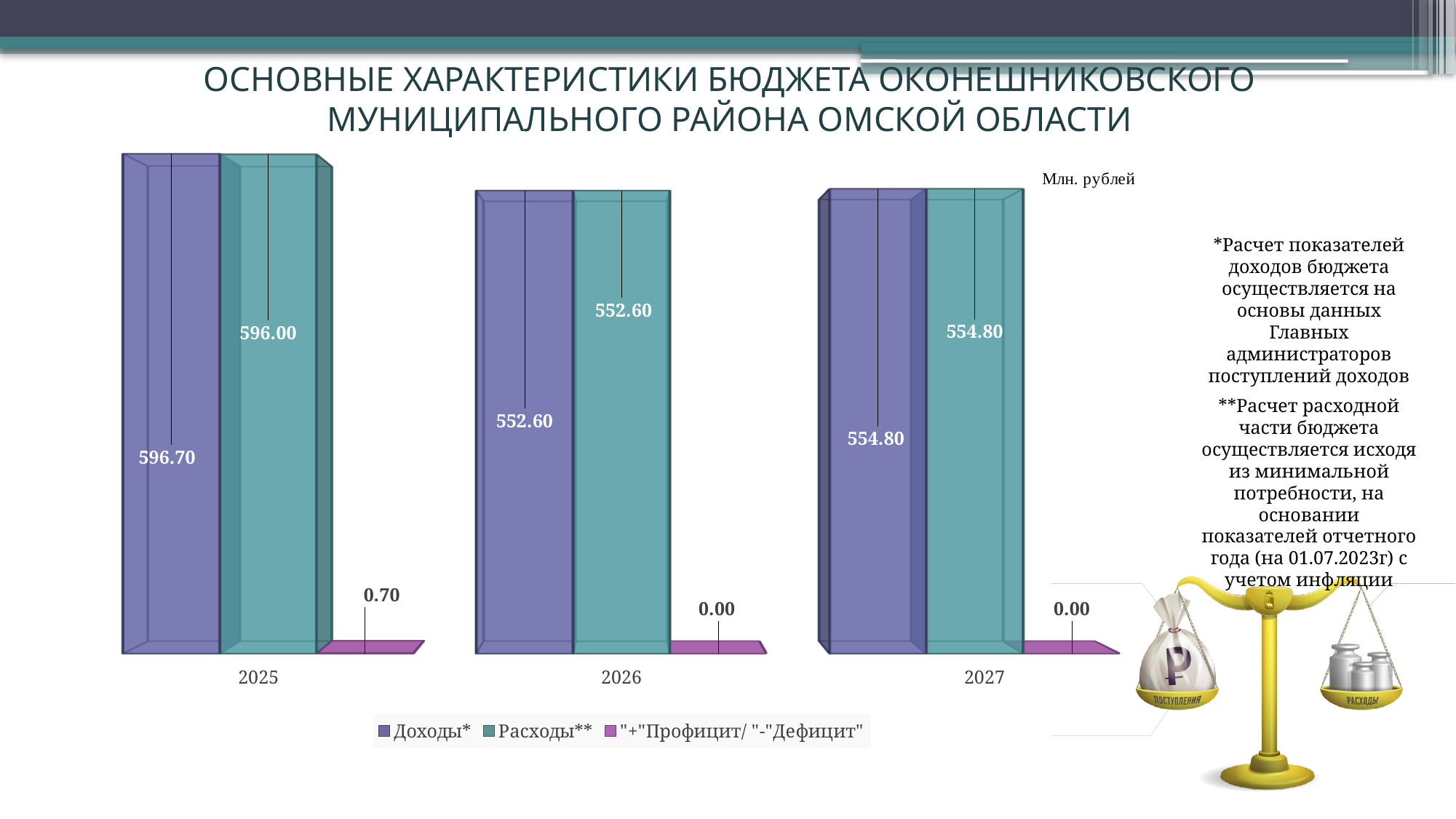
Which year has the highest value for Доходы*? 2025 How many series does the chart legend list? 3 What is the value of Расходы** for 2027? 554.80 What is the difference between Доходы* in 2025 and Доходы* in 2026? 44.10 How many years are shown on the x axis of the chart? 3 What is the value of "+"Профицит/ "-"Дефицит" for 2025? 0.70 What type of chart is shown on the slide? Bar chart Which year has the lowest value for Расходы**? 2026 What is the value of Доходы* for 2025? 596.70 Which is larger: Расходы** in 2027 or Расходы** in 2026? Расходы** in 2027 What is the value of Расходы** for 2026? 552.60 What is the difference between Доходы* and Расходы** in 2025? 0.70